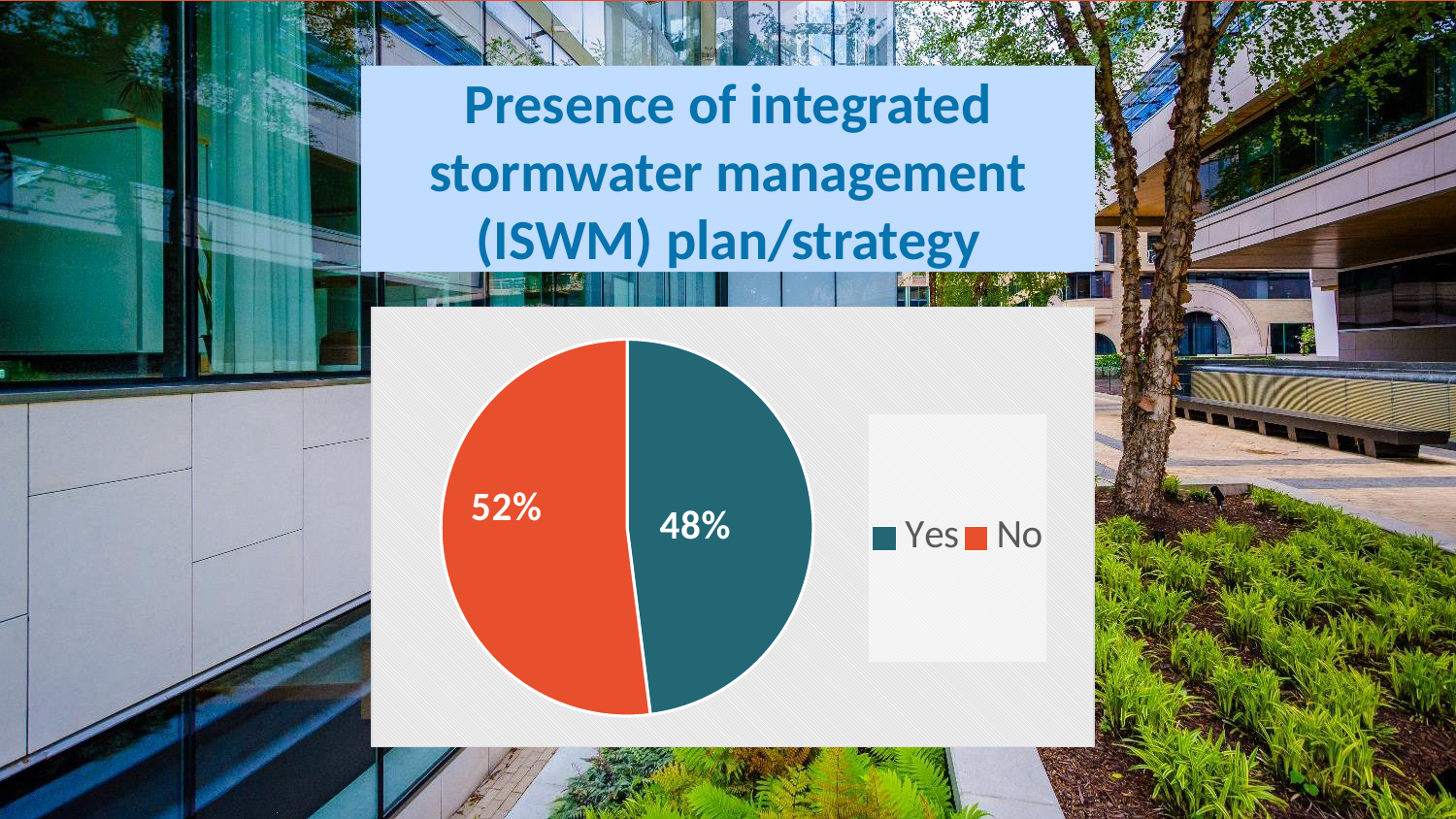
How many slices does the pie chart have? 2 Which slice is larger, Yes or No? No How many entries does the legend list? 2 What colour is the "No" slice in the pie chart? orange-red What kind of chart is shown on the slide? pie chart Which category has the smallest slice of the pie? Yes What is the title of the chart? Presence of integrated stormwater management (ISWM) plan/strategy What share of the pie is labelled "No"? 52% Which category has the largest slice of the pie? No What is the difference in percentage points between the No slice and the Yes slice? 4 percentage points What share of the pie is labelled "Yes"? 48%